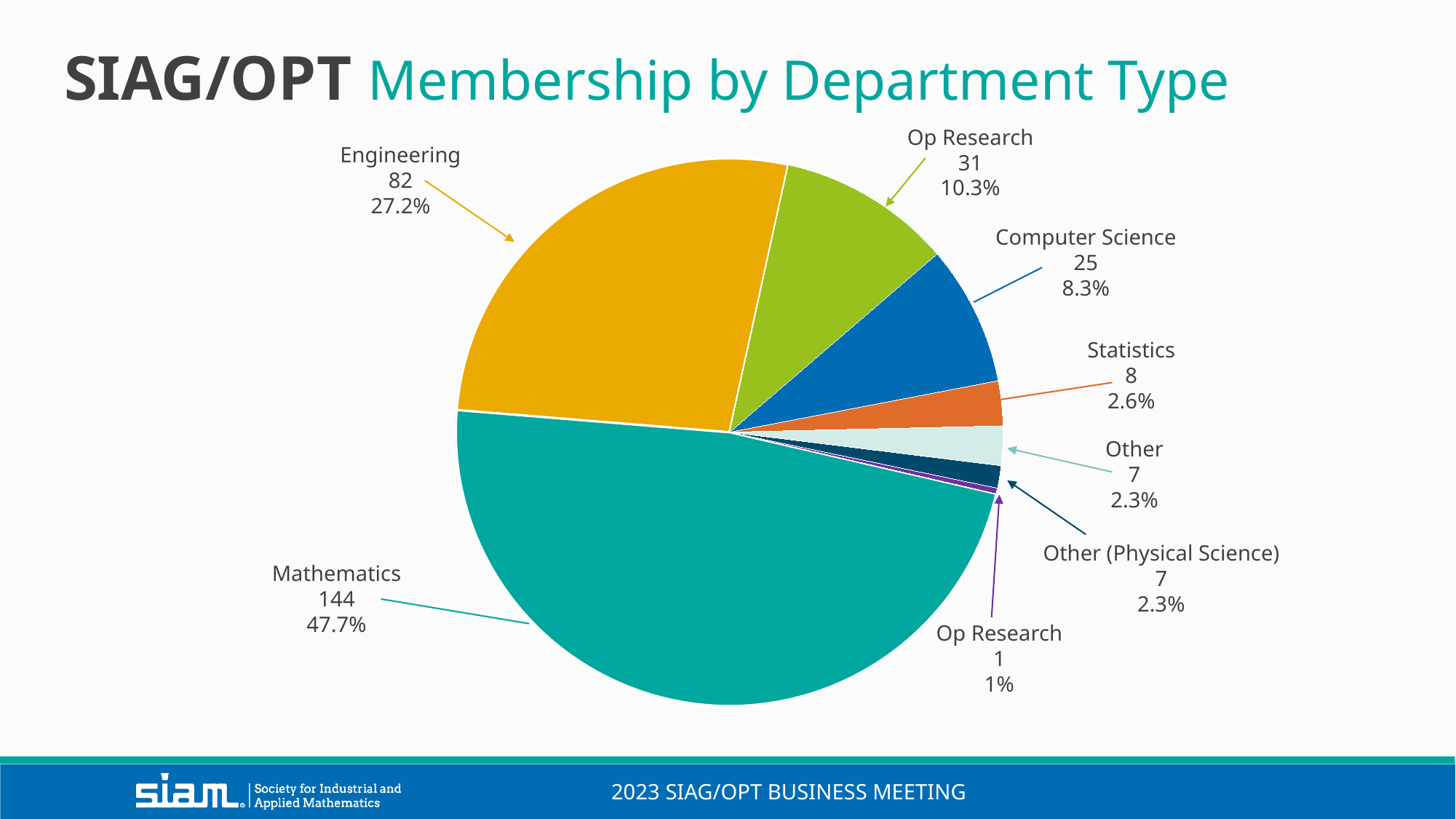
How many members are in the Mathematics slice? 144 What share of the pie does Engineering represent? 27.2% Which has more members, Computer Science or Statistics? Computer Science What kind of chart is shown on the slide? pie chart What is the title of the slide containing the chart? SIAG/OPT Membership by Department Type Which department type has the largest slice of the pie? Mathematics How many members are in the Other (Physical Science) slice? 7 How many slices does the pie chart have? 8 Which slice of the pie is the smallest? Op Research (1, 1%) What is the difference in members between Mathematics and Engineering? 62 What percentage of the pie is Statistics? 2.6% How many members are in the Computer Science slice? 25